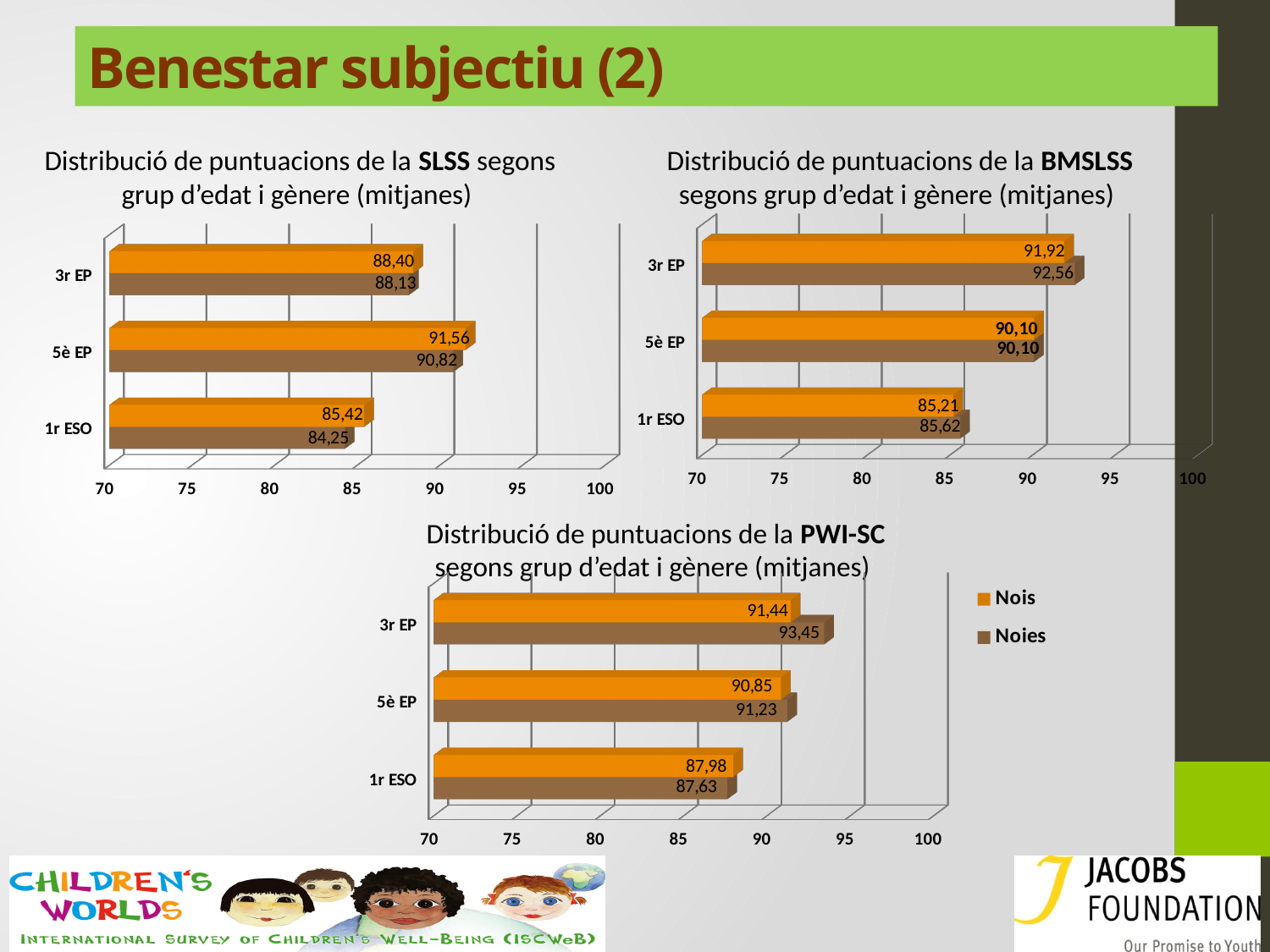
In the PWI-SC chart, what is the difference between the Noies and Nois values for 3r EP? 2,01 In the SLSS chart, what is the value of the brown (Noies) bar for 1r ESO? 84,25 In the SLSS chart, what is the value of the orange (Nois) bar for 5è EP? 91,56 In the PWI-SC chart, which age group has the highest Noies value? 3r EP How many series does the legend of the PWI-SC chart list? 2 In the BMSLSS chart, which is larger for 1r ESO: the orange (Nois) bar or the brown (Noies) bar? Noies (85,62) In the SLSS chart, which age group has the lowest orange (Nois) value? 1r ESO In the BMSLSS chart, is the orange (Nois) value for 5è EP greater or less than 85? greater In the PWI-SC chart, what is the value for Nois in 1r ESO? 87,98 In the BMSLSS chart, what is the value of the brown (Noies) bar for 3r EP? 92,56 How many age groups are shown in the SLSS chart? 3 What type of chart is the BMSLSS chart? Bar chart